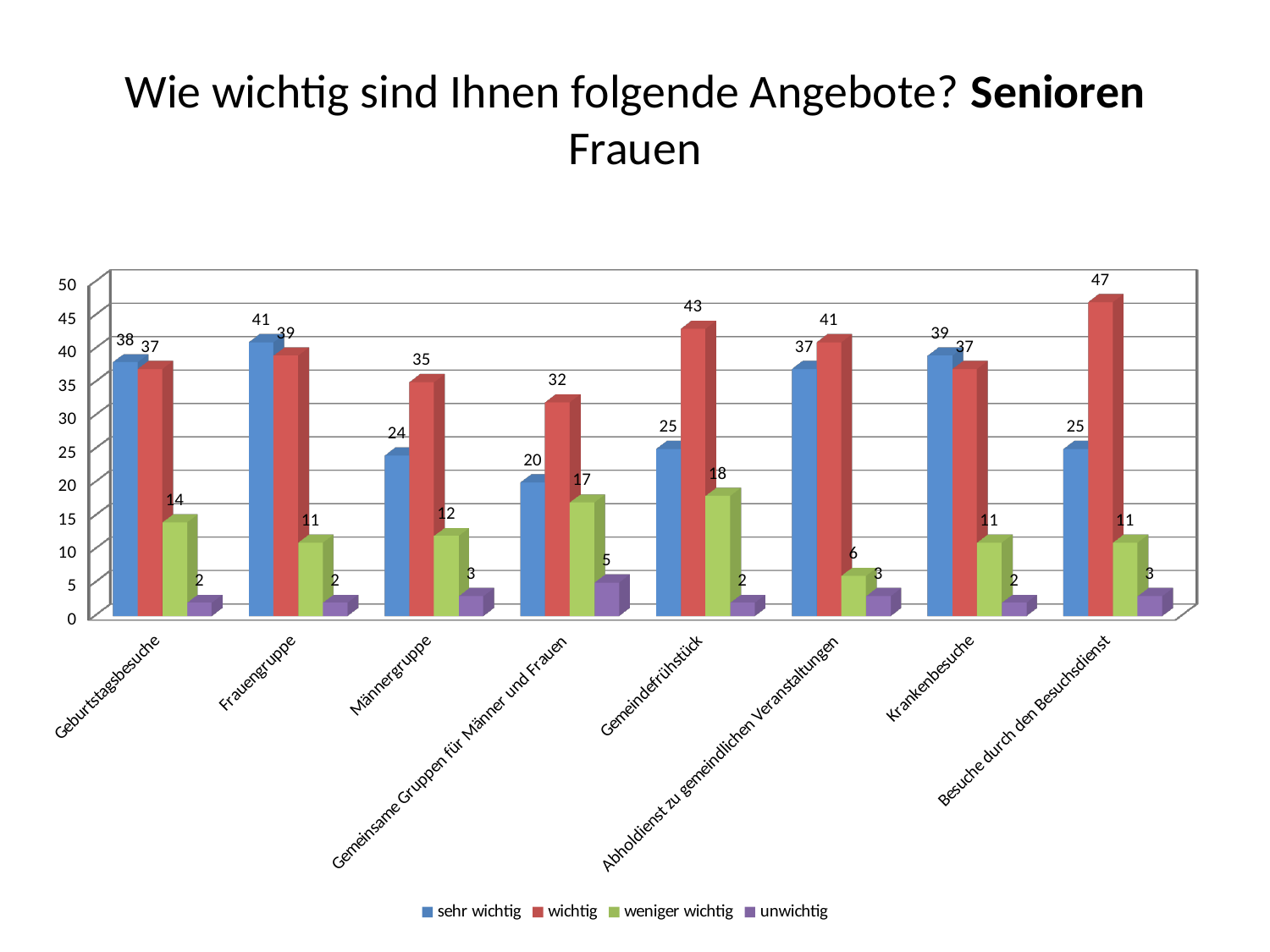
Which category has the lowest "sehr wichtig" value? Gemeinsame Gruppen für Männer und Frauen Which category has the highest "wichtig" value? Besuche durch den Besuchsdienst What is the value for "sehr wichtig" for Frauengruppe? 41 What is the value for "weniger wichtig" for Gemeindefrühstück? 18 Which is larger for Krankenbesuche: "sehr wichtig" or "wichtig"? sehr wichtig What is the difference between the "wichtig" and "sehr wichtig" values for Männergruppe? 11 Which series is shown in purple in the legend? unwichtig How many series does the legend list? 4 What is the value for "wichtig" for Besuche durch den Besuchsdienst? 47 What kind of chart is shown on the slide? bar chart What is the value for "unwichtig" for Gemeinsame Gruppen für Männer und Frauen? 5 How many categories are shown on the x axis? 8